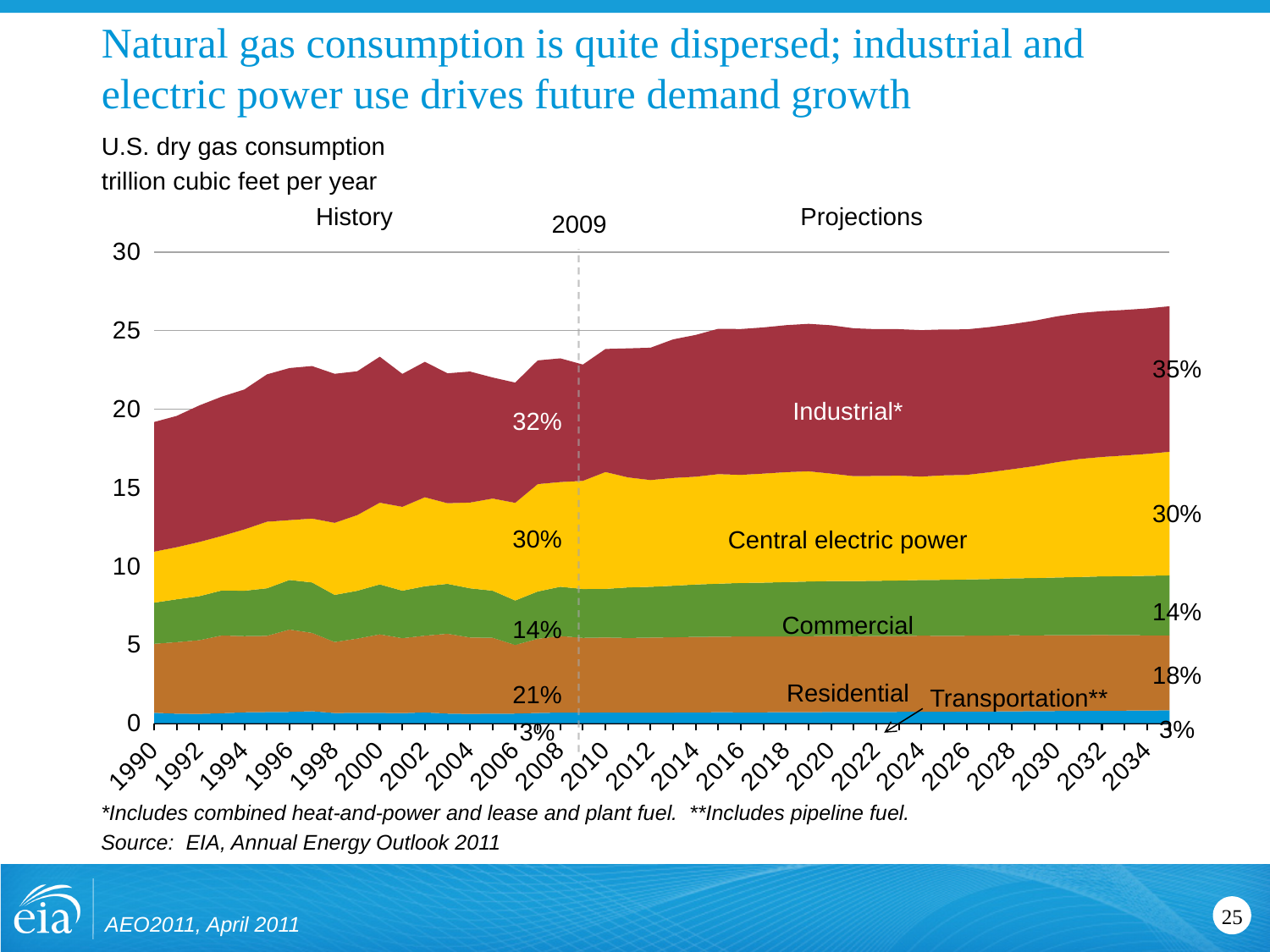
What share of U.S. dry gas consumption does the Industrial* sector account for in 2009? 32% What kind of chart is shown on the slide? stacked area chart How many consumption sectors are plotted in the chart? 5 What share of consumption does Transportation** account for in 2009? 3% What share of consumption is projected for the Industrial* sector at the end of the projection period? 35% Which sector has the smallest share of consumption in 2009? Transportation** Which sector has the largest share of consumption in 2009? Industrial* What share of consumption does the Residential sector account for in 2009? 21% By how many percentage points does the Industrial* share change from 2009 to the end of the projection period? 3 percentage points Is total U.S. dry gas consumption in 1990 greater or less than 20 trillion cubic feet per year? less What share of consumption is projected for the Residential sector at the end of the projection period? 18% What unit is used on the y axis of the chart? trillion cubic feet per year